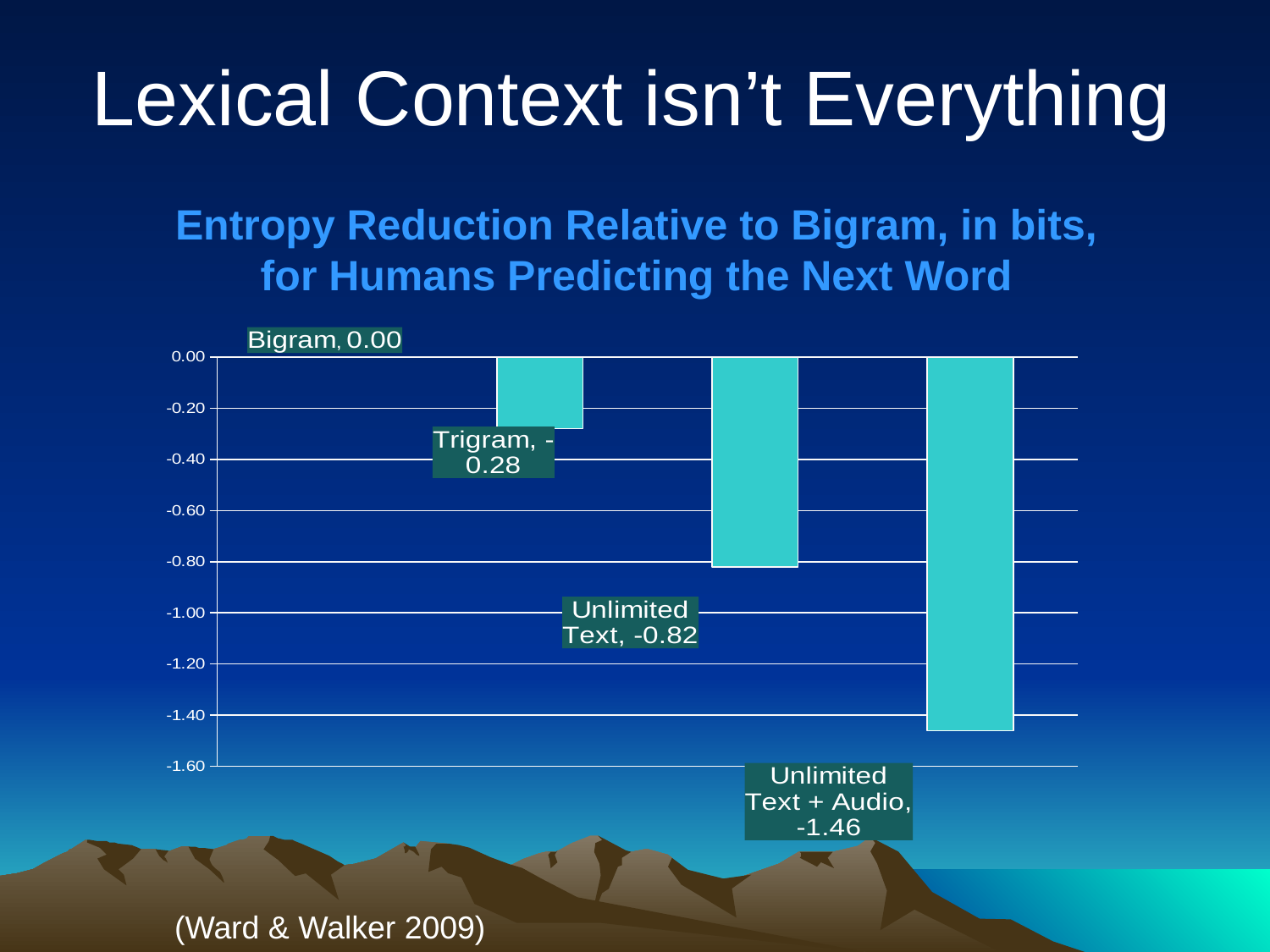
What is the entropy reduction value for Unlimited Text + Audio? -1.46 What is the entropy reduction value for Trigram? -0.28 What is the value shown for Bigram? 0.00 How many categories are plotted in the chart? 4 Which has a larger entropy reduction (more negative value), Trigram or Unlimited Text? Unlimited Text What is the entropy reduction value for Unlimited Text? -0.82 What kind of chart is shown on the slide? Bar chart What is the difference between the values for Unlimited Text + Audio and Unlimited Text? 0.64 What is the title of the chart? Entropy Reduction Relative to Bigram, in bits, for Humans Predicting the Next Word Which category has the highest value? Bigram Which category has the lowest (most negative) value? Unlimited Text + Audio What is the difference between the values for Unlimited Text and Trigram? 0.54